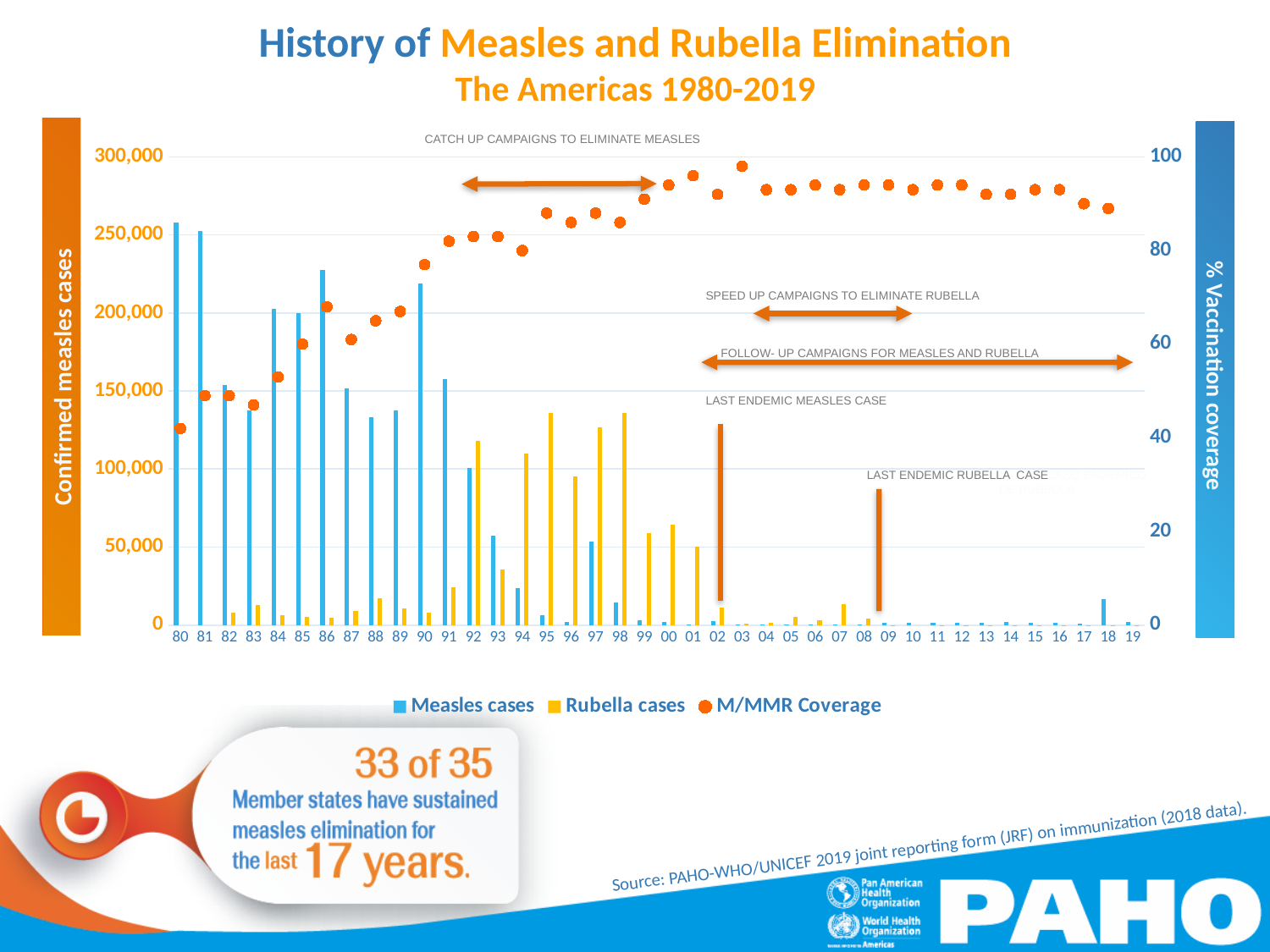
Which is larger, Measles cases in 80 or Measles cases in 90? 80 How many years are shown along the x axis? 40 Is the value for Measles cases in 90 greater or less than 200,000? greater Is the value for Measles cases in 80 greater or less than 250,000? greater Is the M/MMR Coverage value for 03 greater or less than 80? greater What is the label of the right-hand vertical axis? % Vaccination coverage Does M/MMR Coverage generally rise or fall from 80 to 03? rise Which is larger, M/MMR Coverage in 80 or M/MMR Coverage in 03? 03 What kind of chart is this? A bar chart combined with a dot (marker) series for coverage How many series does the legend list? 3